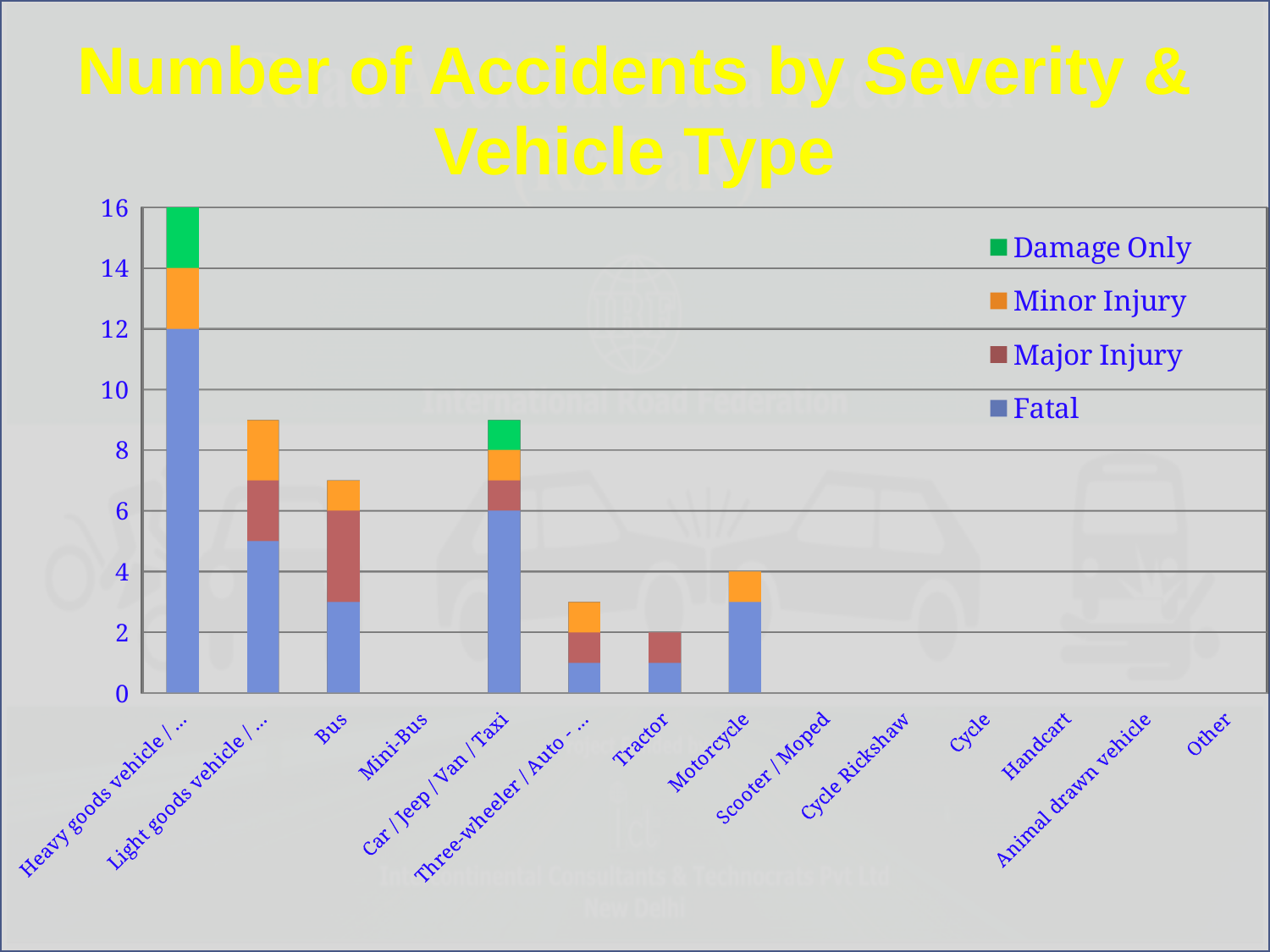
How many vehicle type categories are shown on the x axis? 14 What kind of chart is shown on the slide? Stacked bar chart Which series is listed first (at the top) in the legend? Damage Only How many series does the legend list? 4 Which has a larger total number of accidents, Bus or Motorcycle? Bus What is the total height of the stacked bar for Heavy goods vehicle? 16 What is the Fatal value for Heavy goods vehicle? 12 Which vehicle type has the highest total number of accidents? Heavy goods vehicle What is the Fatal value for Car / Jeep / Van / Taxi? 6